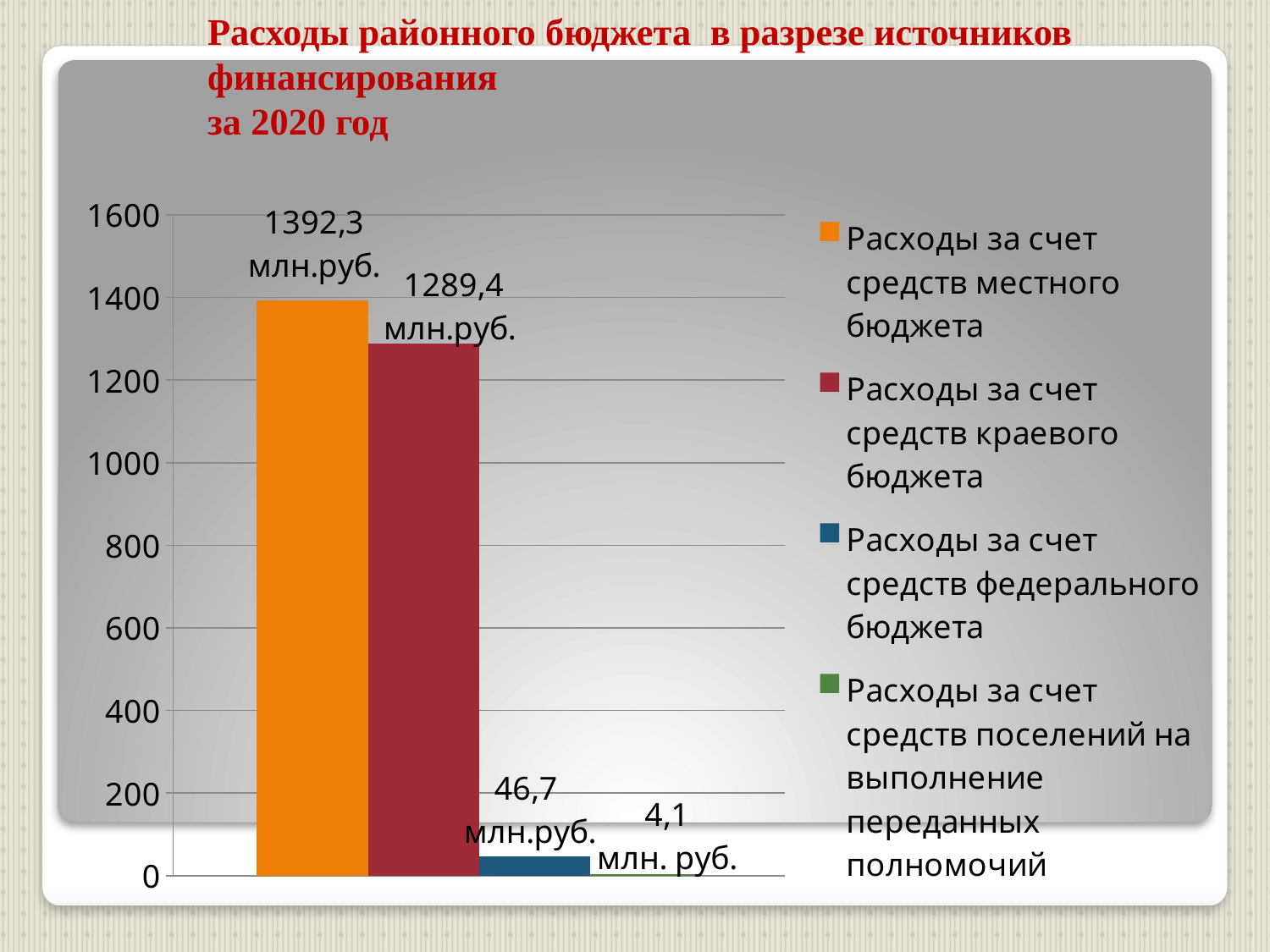
Which funding source has the lowest expenses? Расходы за счет средств поселений на выполнение переданных полномочий What is the value for expenses funded by the federal budget? 46,7 млн.руб. What is the difference between expenses from the federal budget and expenses from settlement funds? 42,6 млн.руб. What is the value for expenses funded by the local budget (Расходы за счет средств местного бюджета)? 1392,3 млн.руб. Which is larger: expenses from the regional (краевого) budget or expenses from the federal budget? Расходы за счет средств краевого бюджета What is the value for expenses funded by settlement funds for transferred powers (средств поселений)? 4,1 млн. руб. What is the value for expenses funded by the regional (краевого) budget? 1289,4 млн.руб. What is the difference between expenses from the local budget and expenses from the regional (краевого) budget? 102,9 млн.руб. What colour is the bar for expenses funded by the local budget? Orange How many series does the legend list? 4 What kind of chart is shown on the slide? Bar chart Which funding source has the highest expenses? Расходы за счет средств местного бюджета